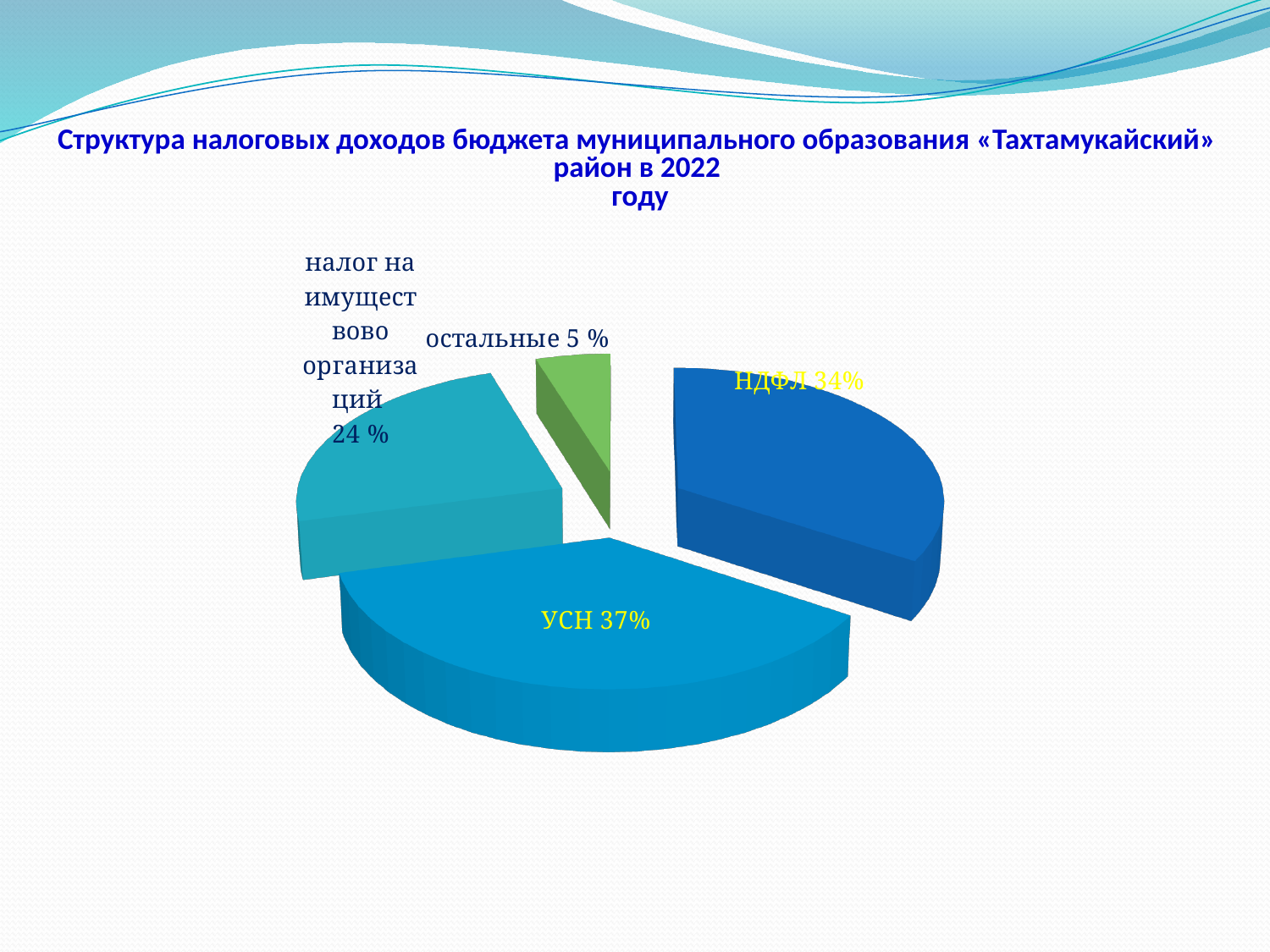
What share of tax revenues does УСН account for in the pie chart? 37% How many slices does the pie chart have? 4 Which year does the chart title say the tax revenue structure refers to? 2022 What type of chart is shown on the slide? pie chart What percentage is shown for НДФЛ in the pie chart? 34% Which slice of the pie chart is the largest? УСН Which is larger: the share of НДФЛ or the share of налог на имущество организаций? НДФЛ By how many percentage points does УСН exceed НДФЛ? 3 What share is shown for налог на имущество организаций? 24 % Which slice of the pie chart is the smallest? остальные By how many percentage points does НДФЛ exceed остальные? 29 What percentage is labelled for the остальные slice? 5 %